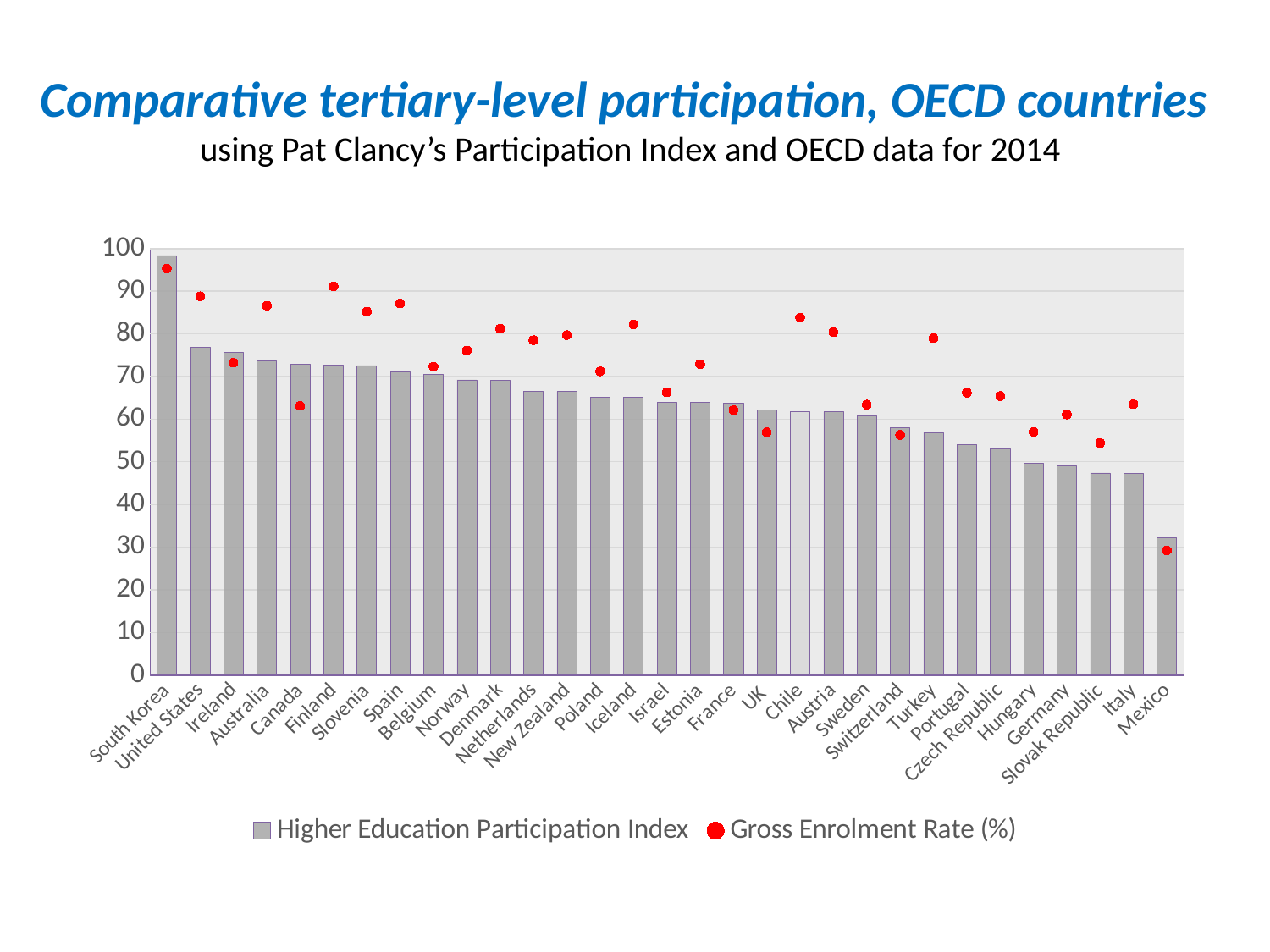
Do the Higher Education Participation Index bars rise or fall from left to right along the x axis? fall Is the Higher Education Participation Index for Mexico greater or less than 40? less Which has the higher Gross Enrolment Rate (%), Finland or Canada? Finland Is the Gross Enrolment Rate (%) for Chile greater or less than 80? greater How many series does the legend list? 2 Which country has the lowest Gross Enrolment Rate (%) dot? Mexico How many countries are shown on the x axis? 31 Is the Gross Enrolment Rate (%) for Canada greater or less than 70? less What kind of chart is shown on the slide? bar chart (with a dot series overlaid) Which country has the lowest Higher Education Participation Index bar? Mexico Which country has the highest Higher Education Participation Index bar? South Korea